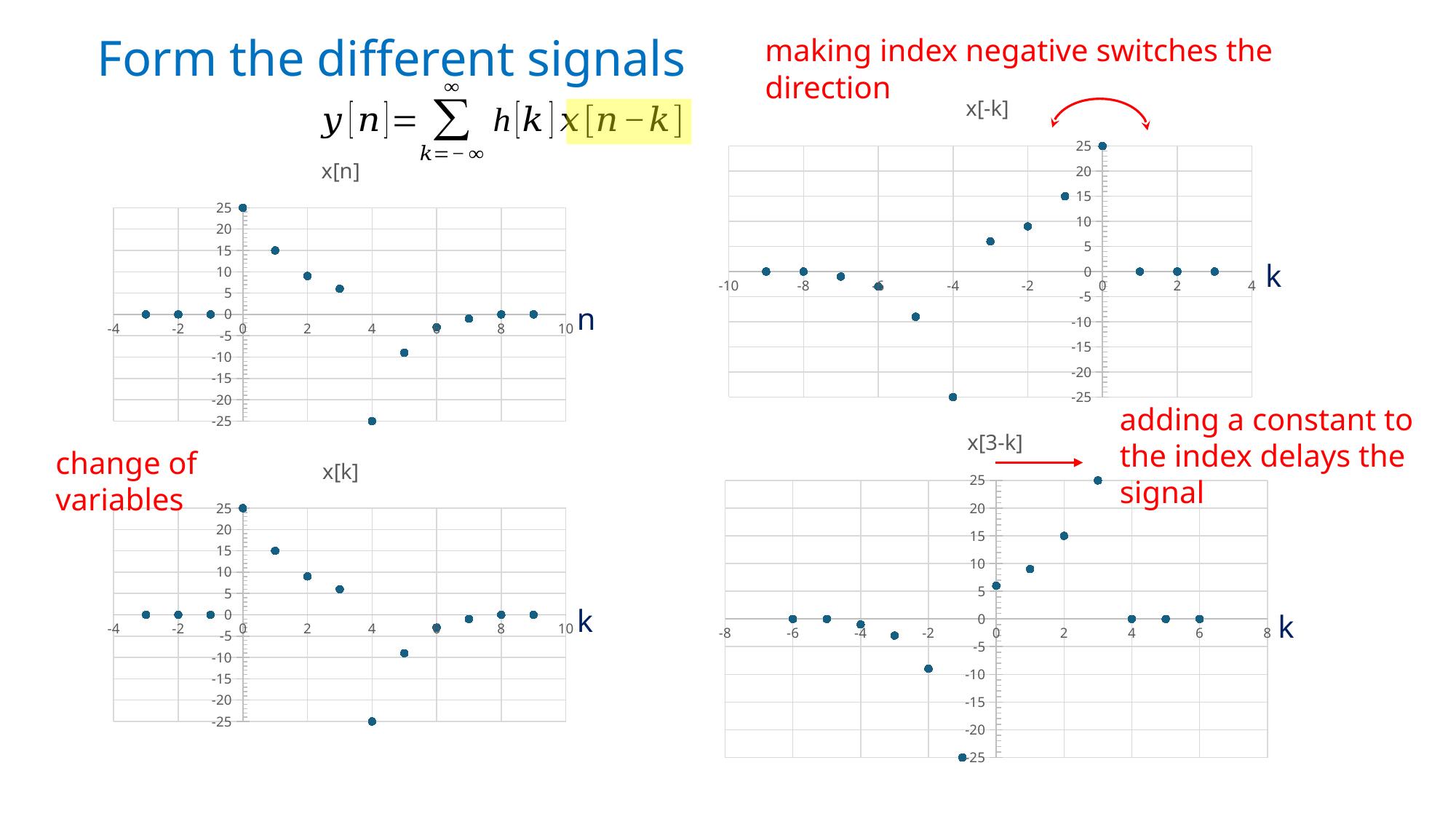
In the x[n] chart, what is the value at n = 4? -25 What kind of chart is the x[n] chart? scatter chart In the x[n] chart, is the value at n = 5 greater or less than -5? less In the x[n] chart, at which value of n is the signal lowest? n = 4 In the x[3-k] chart, what is the value at k = 3? 25 In the x[n] chart, which is larger: the value at n = 1 or the value at n = 3? n = 1 In the x[n] chart, at which value of n is the signal highest? n = 0 How many data points are plotted in the x[n] chart? 13 In the x[-k] chart, what is the value at k = -4? -25 In the x[n] chart, what is the value at n = 0? 25 In the x[n] chart, is the value at n = 2 greater or less than 5? greater In the x[3-k] chart, at which value of k is the signal lowest? k = -1